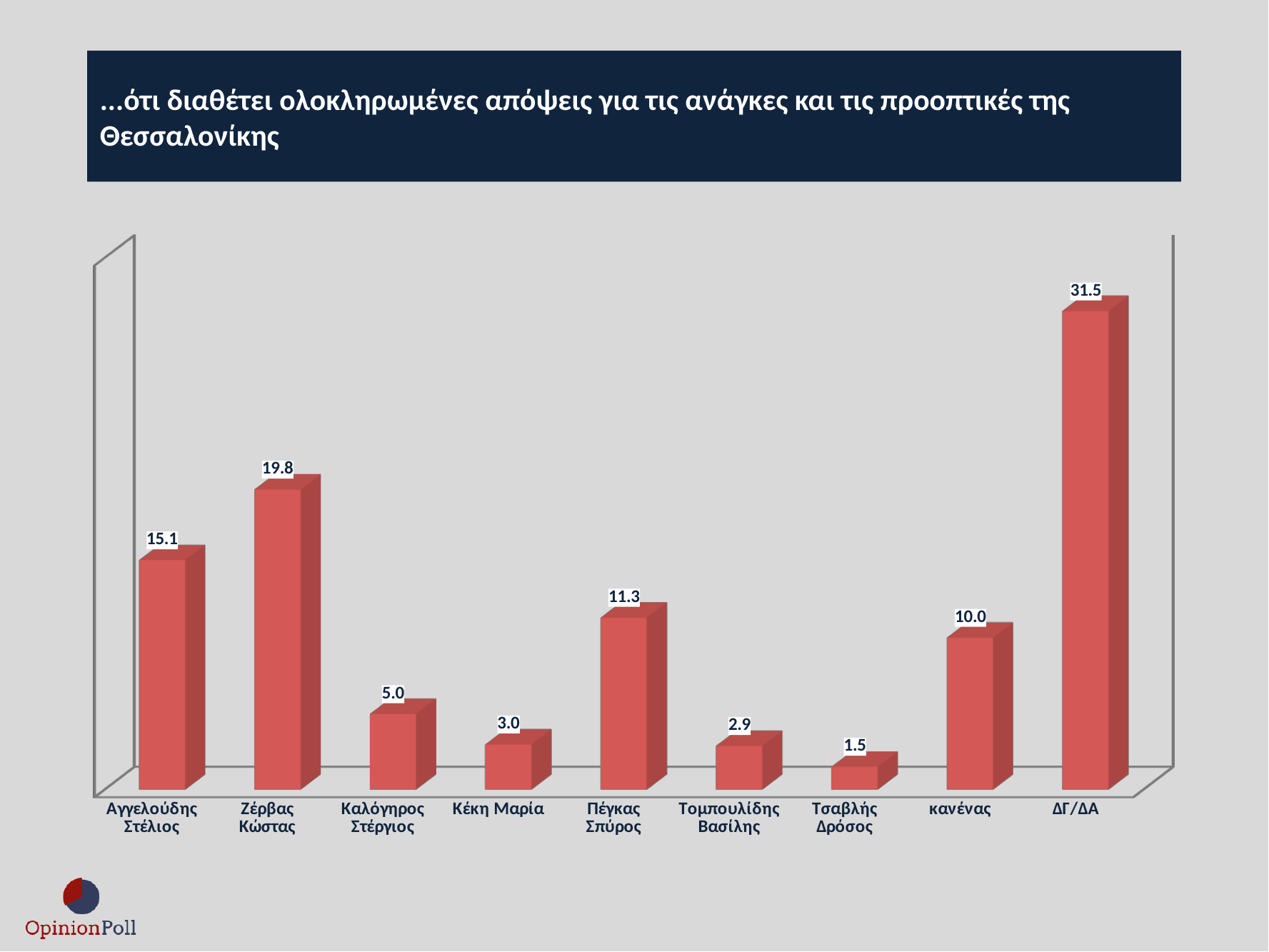
Which is larger, the value for Καλόγηρος Στέργιος or the value for Κέκη Μαρία? Καλόγηρος Στέργιος Which category has the lowest value? Τσαβλής Δρόσος What is the difference between the values for Ζέρβας Κώστας and Αγγελούδης Στέλιος? 4.7 Which category has the highest value? ΔΓ/ΔΑ What is the value for Πέγκας Σπύρος? 11.3 How many categories are shown on the x axis? 9 What is the difference between the values for ΔΓ/ΔΑ and Πέγκας Σπύρος? 20.2 What is the value for Τσαβλής Δρόσος? 1.5 What kind of chart is shown on the slide? bar chart What is the value for Ζέρβας Κώστας? 19.8 Which candidate has the highest value among the named candidates (excluding κανένας and ΔΓ/ΔΑ)? Ζέρβας Κώστας What is the value for κανένας? 10.0